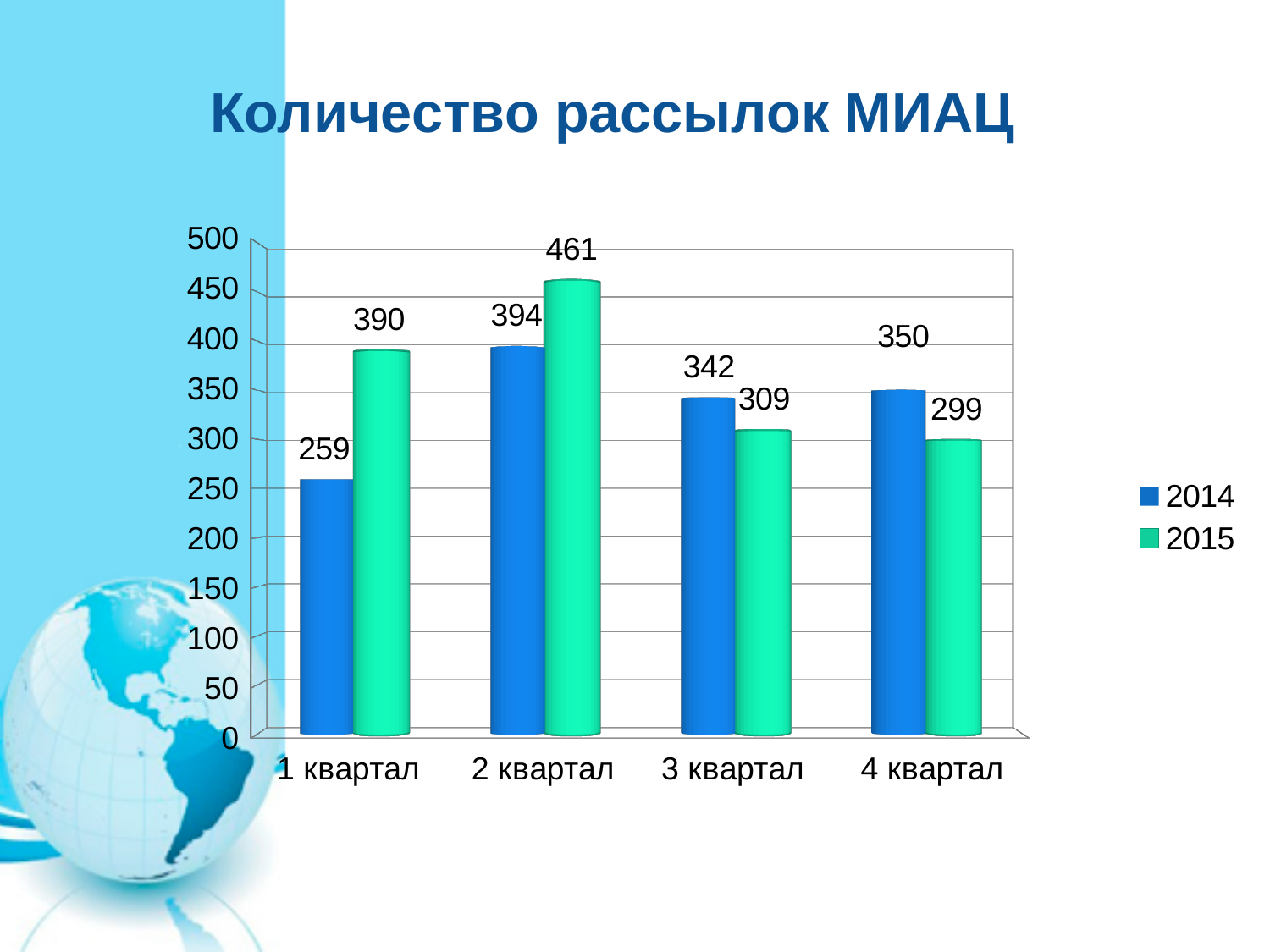
Which quarter has the highest value for 2014? 2 квартал How many quarters are shown on the x axis? 4 What is the title of the chart? Количество рассылок МИАЦ How many series does the legend list? 2 What is the difference between the 2015 and 2014 values in 1 квартал? 131 What is the value for 2015 in 4 квартал? 299 Does the 2015 series rise or fall from 2 квартал to 4 квартал? fall Which quarter has the lowest value for 2015? 4 квартал Which is larger in 3 квартал, the 2014 value or the 2015 value? 2014 What is the value for 2014 in 1 квартал? 259 What kind of chart is shown on the slide? bar chart What is the value for 2015 in 2 квартал? 461